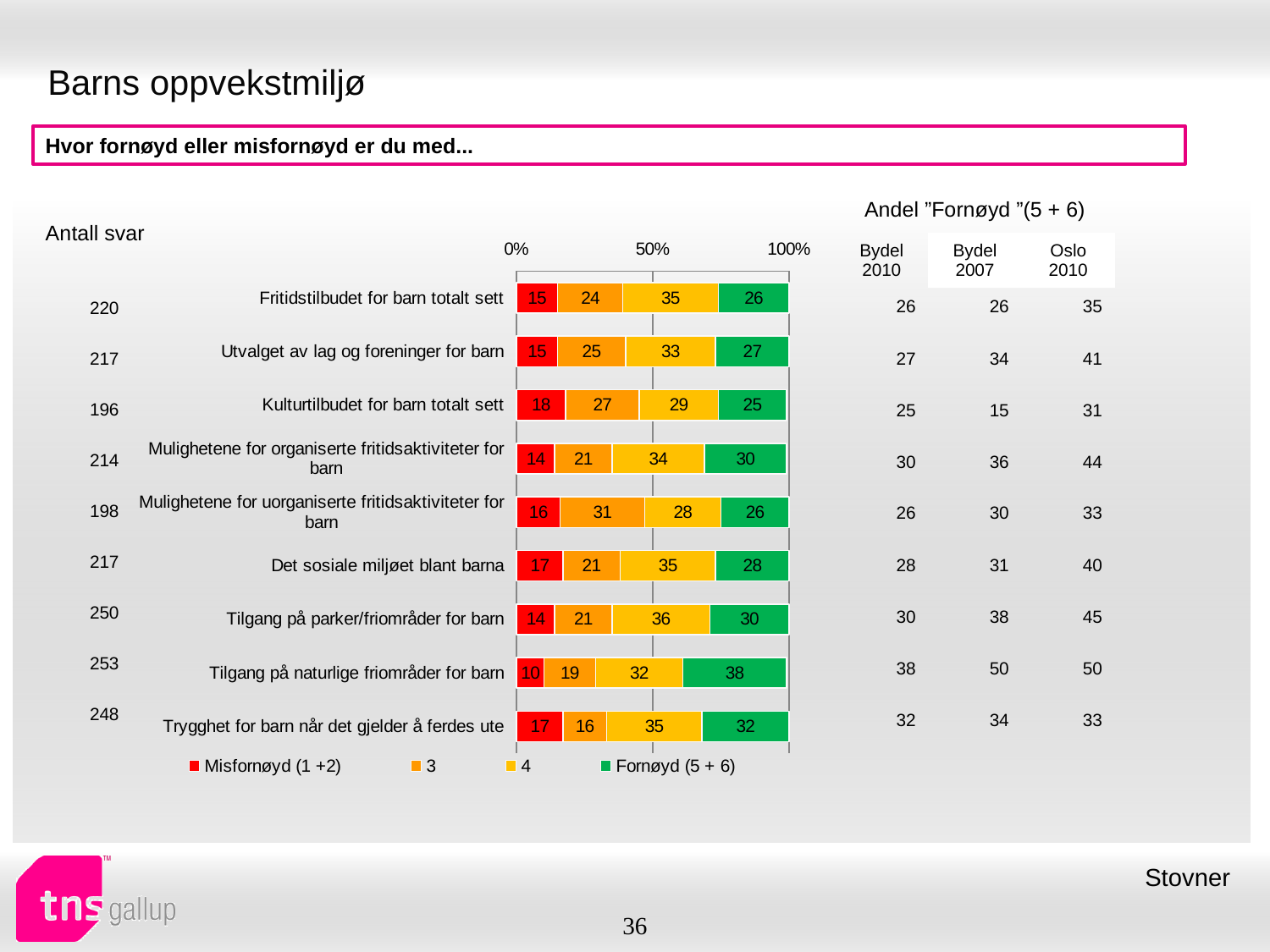
What is the value of series '3' for 'Mulighetene for uorganiserte fritidsaktiviteter for barn'? 31 Which category has the highest 'Fornøyd (5 + 6)' value? Tilgang på naturlige friområder for barn How many categories are plotted in the chart? 9 Which category has the lowest 'Fornøyd (5 + 6)' value? Kulturtilbudet for barn totalt sett What is the difference between the 'Fornøyd (5 + 6)' values for 'Trygghet for barn når det gjelder å ferdes ute' and 'Det sosiale miljøet blant barna'? 4 How many series does the chart legend list? 4 What is the value of 'Fornøyd (5 + 6)' for 'Tilgang på naturlige friområder for barn'? 38 Which category has the lowest 'Misfornøyd (1 +2)' value? Tilgang på naturlige friområder for barn What is the total of the stacked bar for 'Fritidstilbudet for barn totalt sett'? 100 What is the value of 'Misfornøyd (1 +2)' for 'Kulturtilbudet for barn totalt sett'? 18 What kind of chart is shown on the slide? stacked bar chart Which is larger: the 'Misfornøyd (1 +2)' value for 'Det sosiale miljøet blant barna' or for 'Tilgang på parker/friområder for barn'? Det sosiale miljøet blant barna